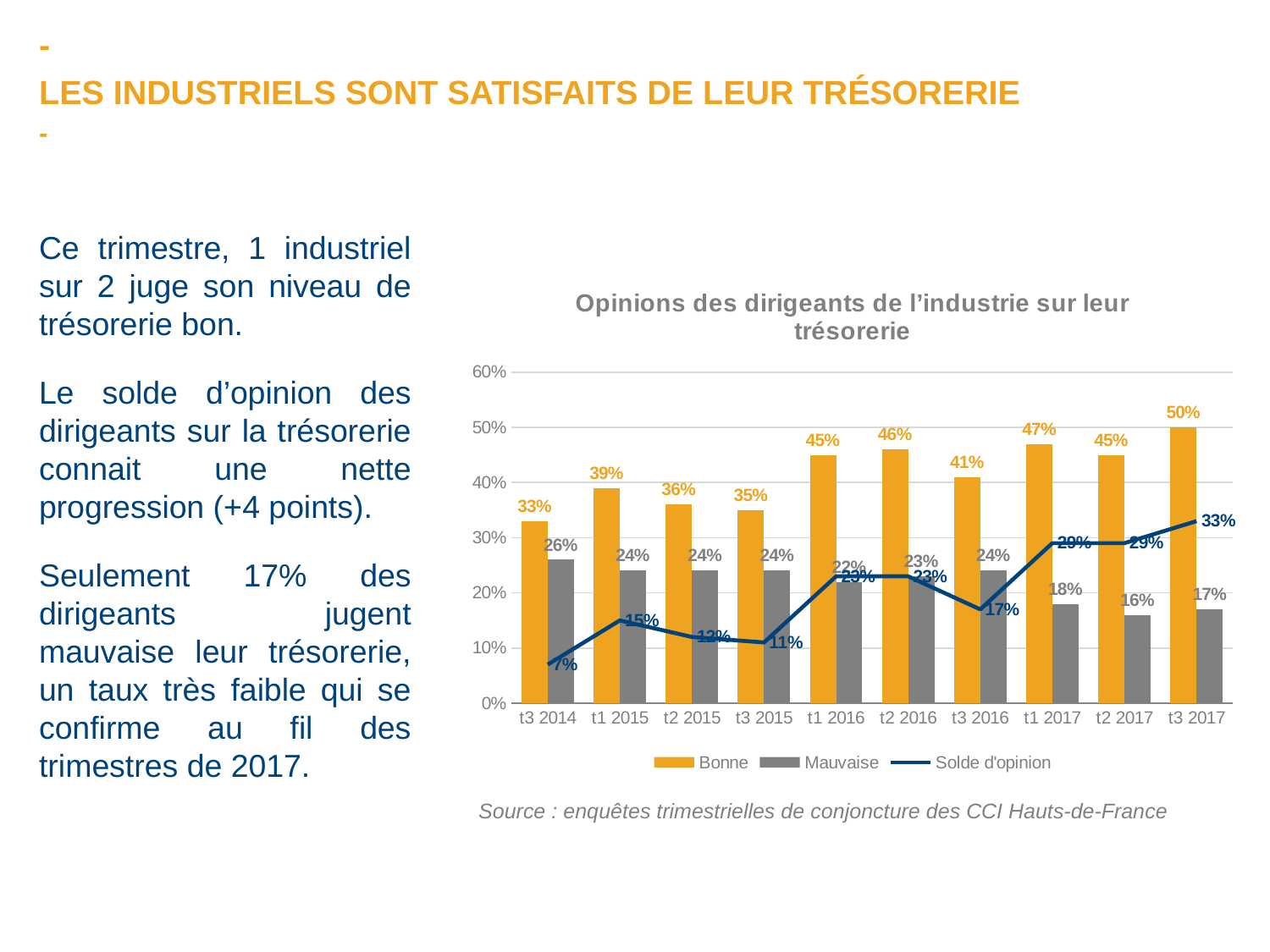
What is the value of the Mauvaise series for t3 2014? 26% How many quarters are shown on the x axis? 10 In which quarter is the Solde d'opinion line lowest? t3 2014 What is the value of the Bonne series for t3 2017? 50% What is the value of the Solde d'opinion line for t1 2017? 29% In which quarter is the Bonne series highest? t3 2017 Does the Solde d'opinion line rise or fall between t3 2016 and t3 2017? Rise What kind of chart is this? Combined bar and line chart What is the title of the chart? Opinions des dirigeants de l'industrie sur leur trésorerie How many series does the legend list? 3 What is the difference between the Bonne and Mauvaise values for t3 2017? 33% Which is larger for t1 2015: the Bonne value or the Mauvaise value? Bonne